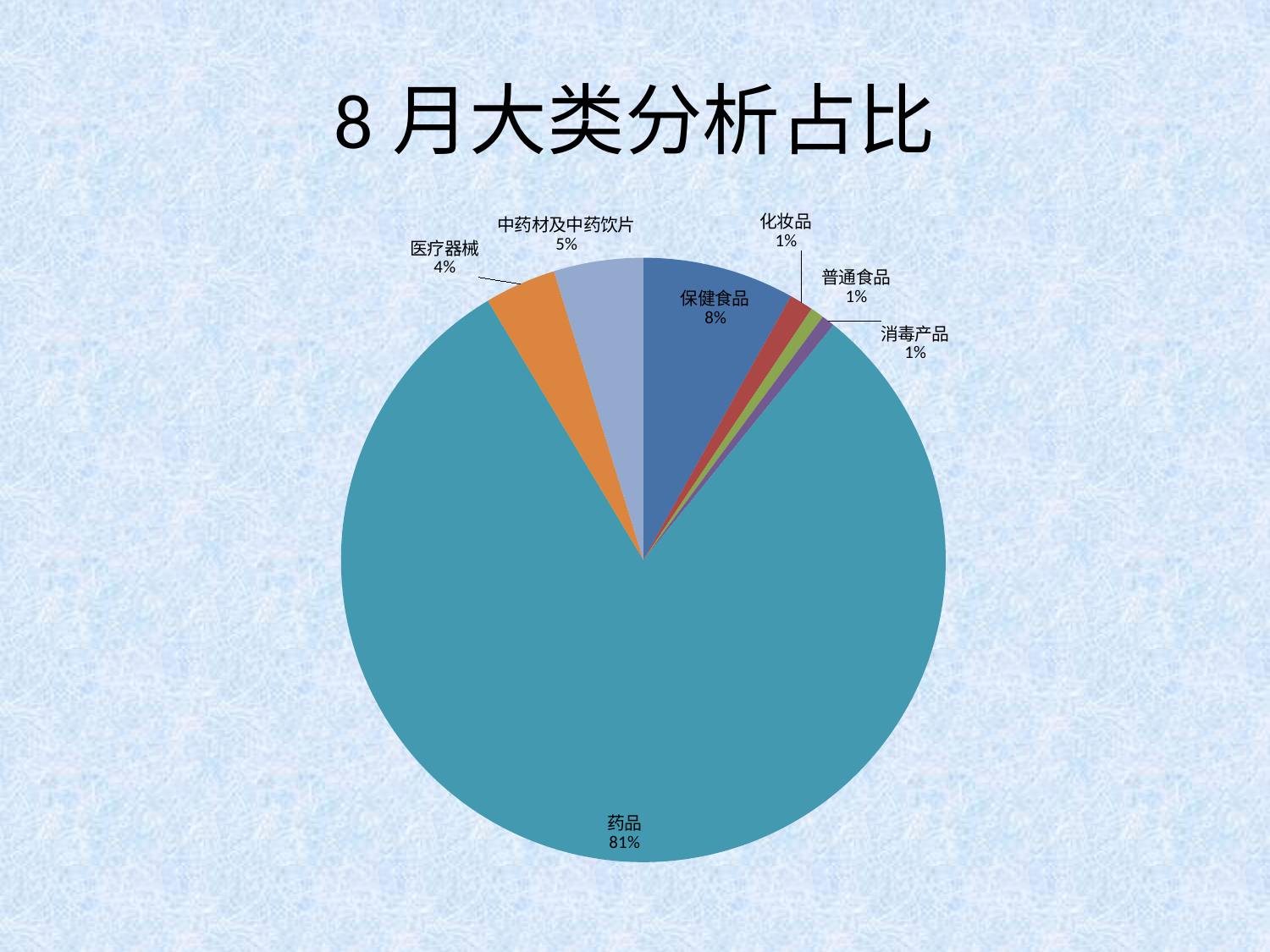
What is the difference in percentage points between 保健食品 and 医疗器械? 4 Which is larger, the share for 中药材及中药饮片 or the share for 医疗器械? 中药材及中药饮片 What share of the pie does 中药材及中药饮片 have? 5% What share of the pie does 保健食品 have? 8% Which category has the largest slice of the pie? 药品 What share of the pie does 化妆品 have? 1% What is the difference in percentage points between 药品 and 保健食品? 73 How many slices does the pie chart have? 7 What kind of chart is shown on the slide? pie chart What is the title of the chart? 8 月大类分析占比